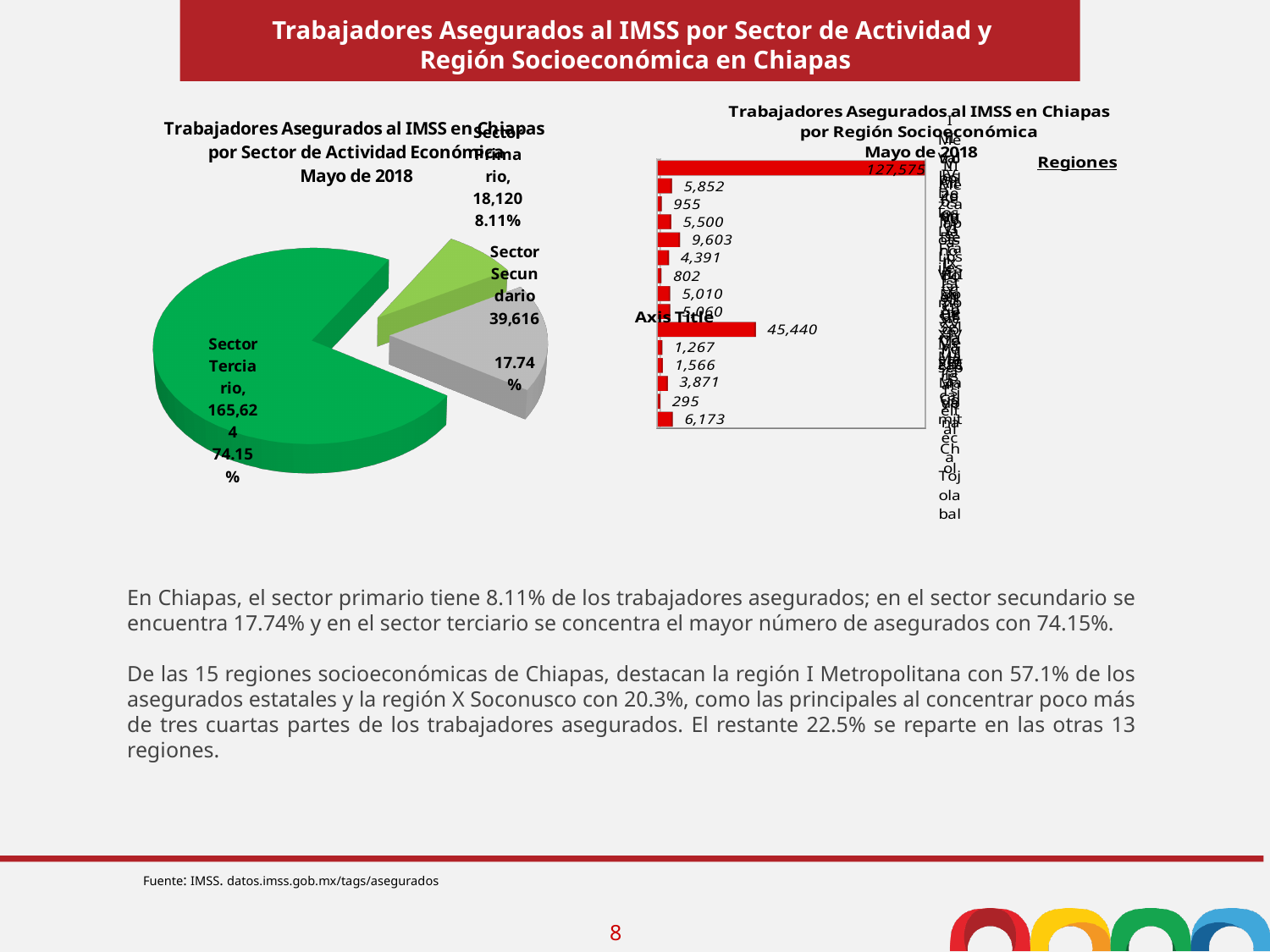
What kind of chart is the chart on the left of the slide? Pie chart In the pie chart on the left, which sector has the largest number of insured workers? Sector Terciario In the pie chart on the left, what is the difference between the values for Sector Secundario and Sector Primario? 21,496 In the pie chart on the left, how many sectors are shown? 3 In the bar chart on the right, what is the largest value shown on any bar? 127,575 In the pie chart on the left, what is the value for Sector Secundario? 39,616 In the pie chart on the left, which sector has the smallest number of insured workers? Sector Primario In the bar chart on the right, how many bars are plotted? 15 In the pie chart 'Trabajadores Asegurados al IMSS en Chiapas por Sector de Actividad Económica', what is the value for Sector Terciario? 165,624 What kind of chart is the chart 'Trabajadores Asegurados al IMSS en Chiapas por Región Socioeconómica' on the right? Bar chart In the pie chart on the left, what percentage share does Sector Primario have? 8.11% In the pie chart on the left, what percentage share does Sector Secundario have? 17.74%